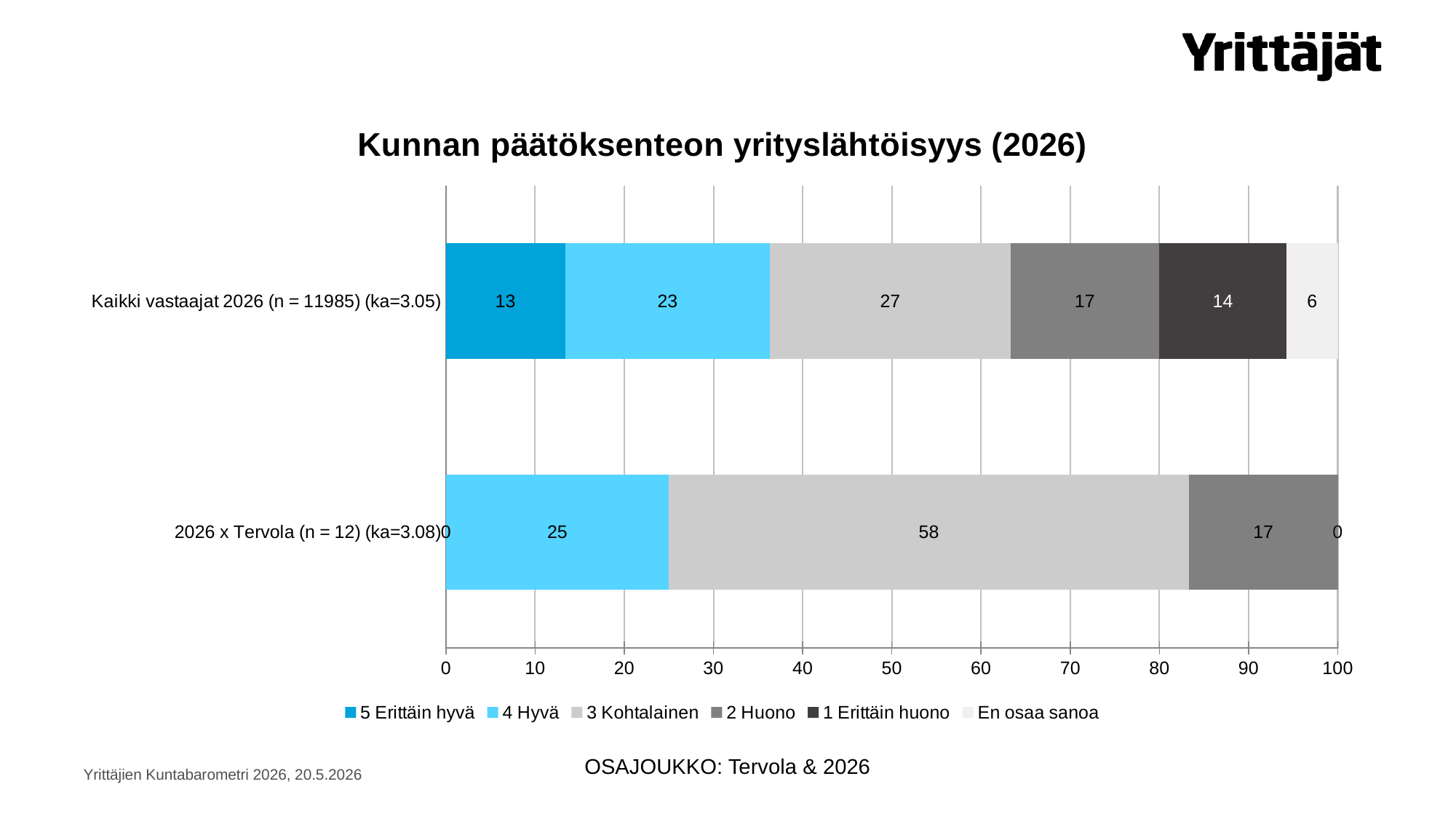
How many categories (bars) are shown in the chart? 2 Which series has the highest value in the 'Kaikki vastaajat 2026 (n = 11985) (ka=3.05)' bar? 3 Kohtalainen What is the value of '1 Erittäin huono' for 'Kaikki vastaajat 2026 (n = 11985) (ka=3.05)'? 14 What is the total of the stacked bar for 'Kaikki vastaajat 2026 (n = 11985) (ka=3.05)'? 100 What kind of chart is shown on the slide? Stacked bar chart What is the value of '5 Erittäin hyvä' for 'Kaikki vastaajat 2026 (n = 11985) (ka=3.05)'? 13 How many series does the legend list? 6 What is the difference between the '3 Kohtalainen' values for '2026 x Tervola (n = 12) (ka=3.08)' and 'Kaikki vastaajat 2026 (n = 11985) (ka=3.05)'? 31 What is the value of '3 Kohtalainen' for '2026 x Tervola (n = 12) (ka=3.08)'? 58 What is the title of the chart? Kunnan päätöksenteon yrityslähtöisyys (2026) What is the value of '5 Erittäin hyvä' for '2026 x Tervola (n = 12) (ka=3.08)'? 0 Which is larger: the '4 Hyvä' value for '2026 x Tervola (n = 12) (ka=3.08)' or for 'Kaikki vastaajat 2026 (n = 11985) (ka=3.05)'? 2026 x Tervola (n = 12) (ka=3.08)